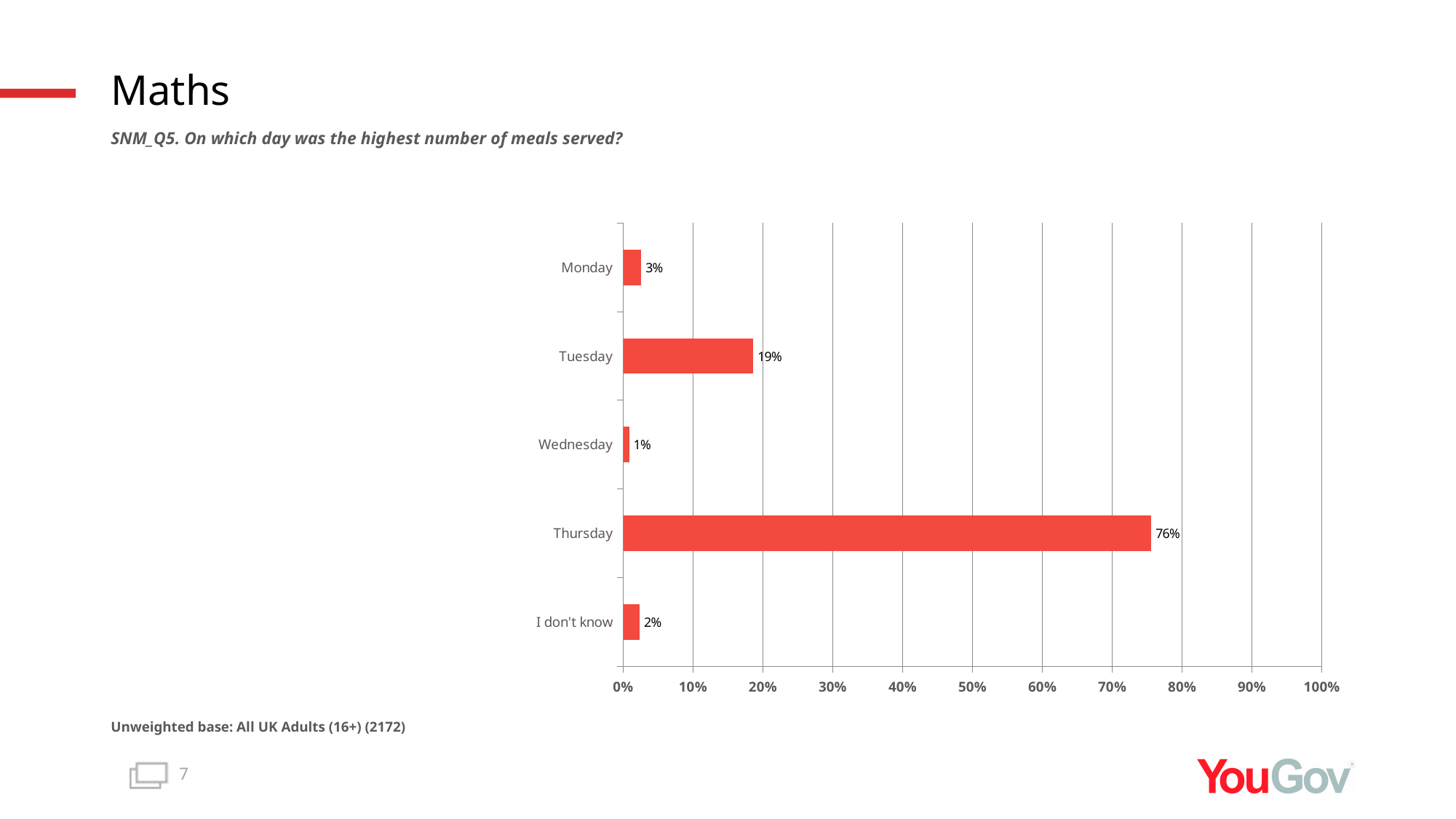
What is the survey question shown above the chart? SNM_Q5. On which day was the highest number of meals served? What is the difference between the values for Thursday and Tuesday? 57% Which category has the highest value? Thursday What kind of chart is shown on the slide? Bar chart What percentage of respondents answered Thursday? 76% Which category has the lowest value? Wednesday How many categories are shown on the chart? 5 Which is larger, the value for Monday or the value for 'I don't know'? Monday What percentage of respondents answered Tuesday? 19% What percentage of respondents answered 'I don't know'? 2% Is the value for Thursday greater or less than 70%? greater What percentage of respondents answered Wednesday? 1%